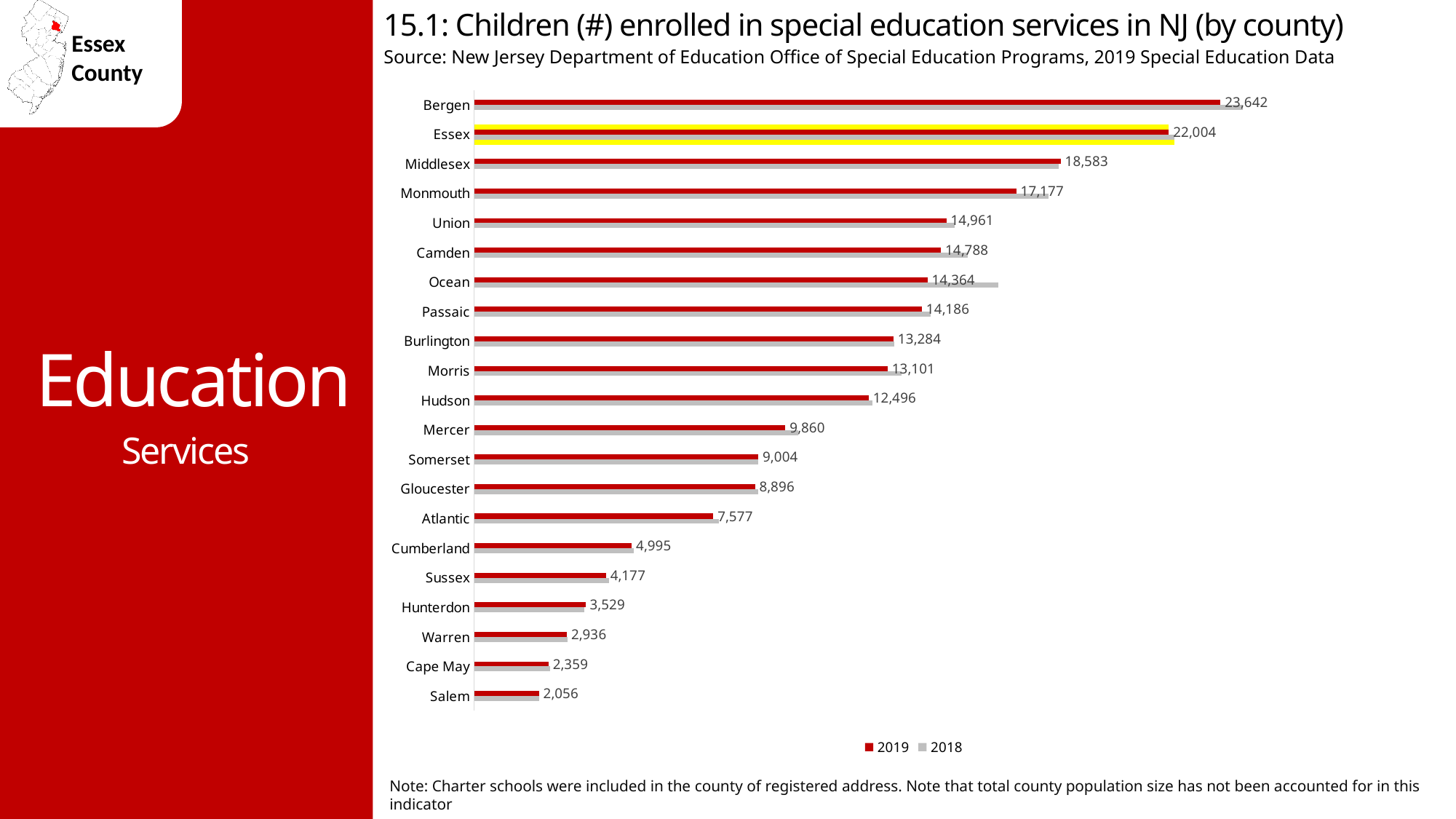
What is the difference between the 2019 values for Bergen and Essex? 1,638 What is the 2019 value for Cape May? 2,359 What is the 2019 value for Hudson? 12,496 What is the 2019 value for Essex? 22,004 How many counties are shown in the chart? 21 Which county has the lowest 2019 value? Salem What type of chart is shown on the slide? bar chart Which county has the highest 2019 value? Bergen What is the difference between the 2019 values for Middlesex and Monmouth? 1,406 How many series does the legend list? 2 Which series is shown in red in the legend? 2019 For Ocean, which is larger, the 2019 value or the 2018 value? 2018